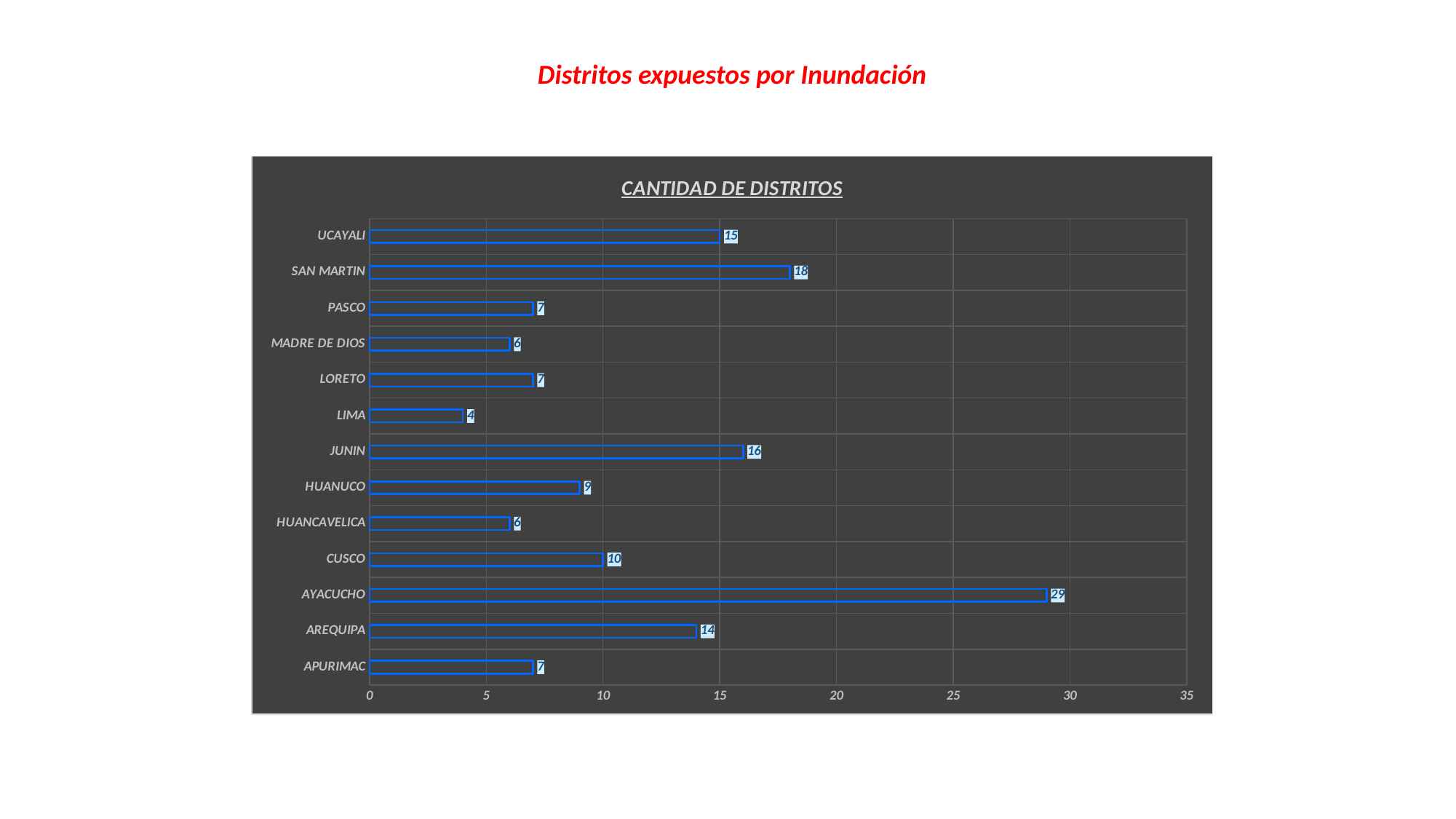
What kind of chart is shown on the slide? bar chart What is the value for AYACUCHO? 29 What is the value for SAN MARTIN? 18 What is the value for LIMA? 4 Which category has the highest value? AYACUCHO Is the value for CUSCO greater or less than 5? greater What is the title of the chart? CANTIDAD DE DISTRITOS What is the difference between the values for AYACUCHO and SAN MARTIN? 11 Which category has the lowest value? LIMA Which is larger, the value for JUNIN or the value for UCAYALI? JUNIN How many categories are shown in the chart? 13 What is the value for HUANUCO? 9